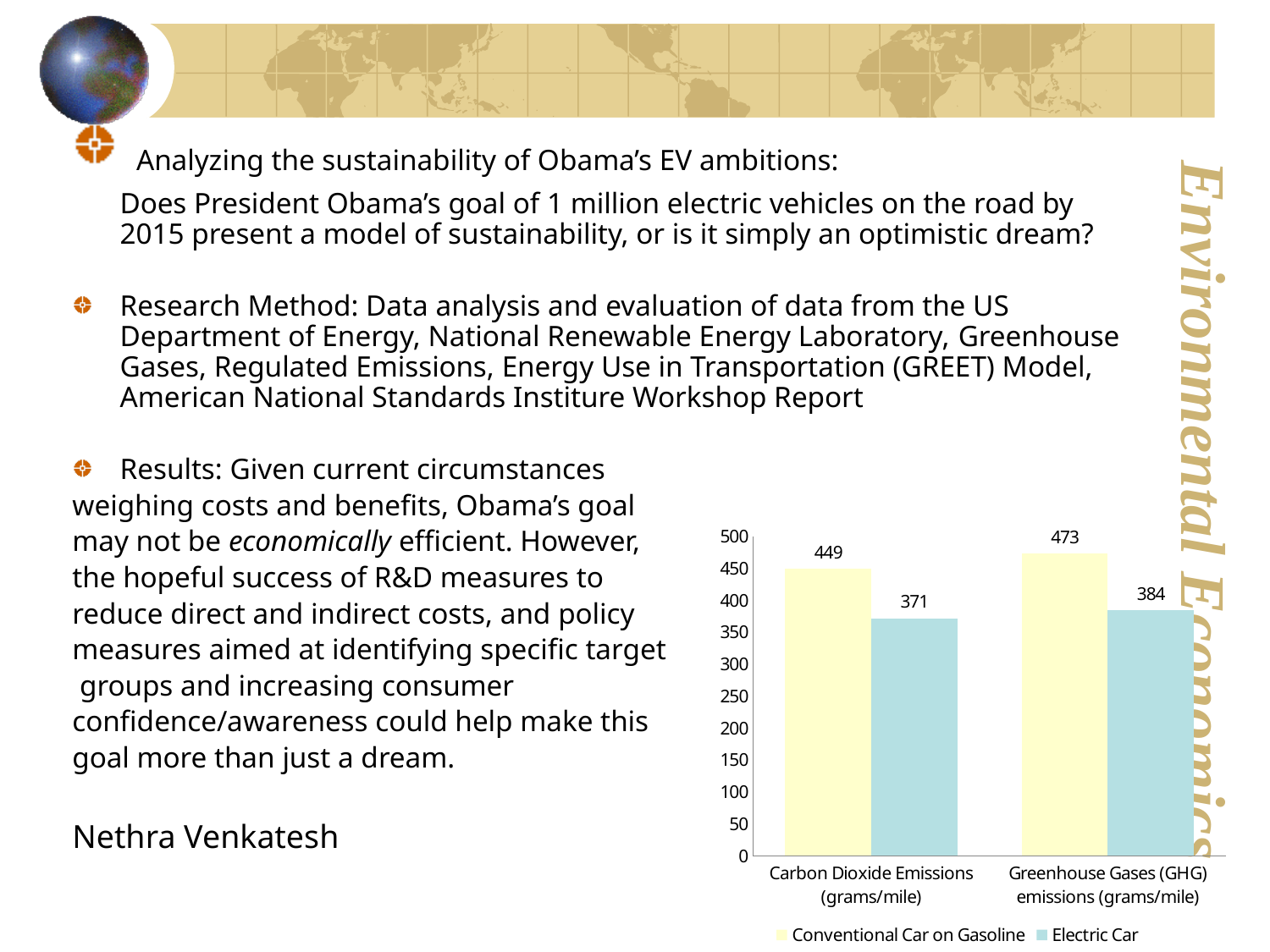
Which bar in the chart has the lowest value? Electric Car, Carbon Dioxide Emissions (grams/mile) What is the value for Electric Car for Carbon Dioxide Emissions (grams/mile)? 371 Which is larger for Greenhouse Gases (GHG) emissions (grams/mile): Conventional Car on Gasoline or Electric Car? Conventional Car on Gasoline What is the difference between the Conventional Car on Gasoline and Electric Car values for Greenhouse Gases (GHG) emissions (grams/mile)? 89 What is the difference between the Conventional Car on Gasoline and Electric Car values for Carbon Dioxide Emissions (grams/mile)? 78 What is the value for Electric Car for Greenhouse Gases (GHG) emissions (grams/mile)? 384 What is the value for Conventional Car on Gasoline for Greenhouse Gases (GHG) emissions (grams/mile)? 473 Which bar in the chart has the highest value? Conventional Car on Gasoline, Greenhouse Gases (GHG) emissions (grams/mile) What is the value for Conventional Car on Gasoline for Carbon Dioxide Emissions (grams/mile)? 449 How many categories are shown on the x axis of the chart? 2 How many series does the chart's legend list? 2 What kind of chart is shown on the slide? Bar chart